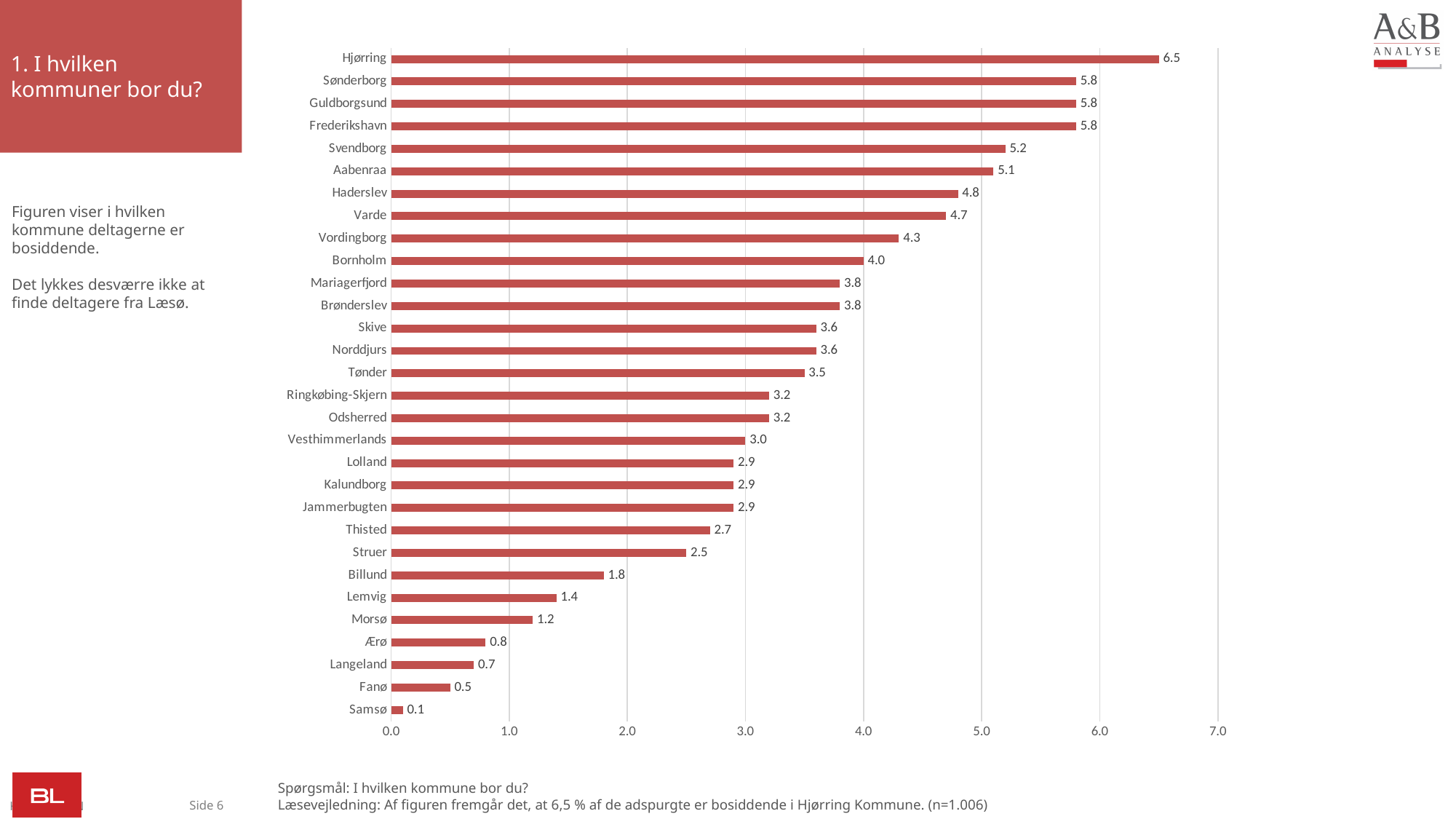
What is the value for Bornholm? 4.0 Which kommune has the lowest value? Samsø What is the difference between the values for Billund and Lemvig? 0.4 What colour are the bars in the chart? red What is the value for Hjørring? 6.5 What is the difference between the values for Hjørring and Svendborg? 1.3 Which is larger, the value for Haderslev or the value for Vordingborg? Haderslev What is the value for Struer? 2.5 What kind of chart is shown on the slide? bar chart Which kommune has the highest value? Hjørring How many kommuner are shown in the chart? 30 Is the value for Aabenraa greater or less than 5.0? greater